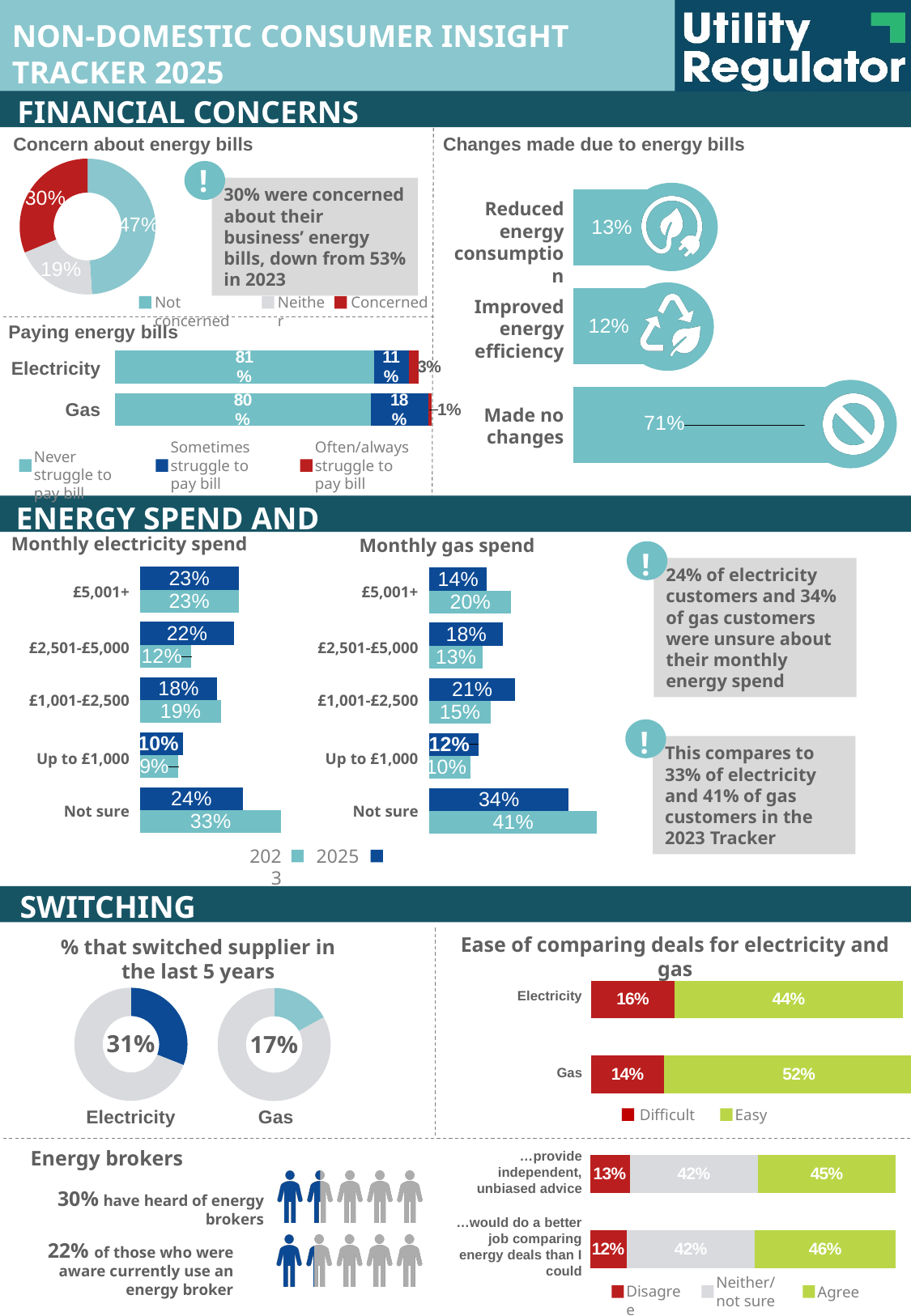
How many series does the legend of the 'Monthly gas spend' chart list? 2 In the 'Paying energy bills' chart, what percentage of gas customers sometimes struggle to pay their bill? 18% What kind of chart is the 'Ease of comparing deals for electricity and gas' chart? Bar chart In the 'Ease of comparing deals for electricity and gas' chart, what is the difference between the Easy values for gas and electricity? 8% In the 'Monthly electricity spend' chart, what is the difference between the 2023 and 2025 values for £2,501-£5,000? 10% In the 'Concern about energy bills' donut chart, which category has the largest share? Not concerned In the 'Monthly gas spend' chart, which is larger for £5,001+: the 2023 value or the 2025 value? 2023 In the 'Changes made due to energy bills' chart, what percentage made no changes? 71% In the 'Concern about energy bills' donut chart, what percentage were concerned? 30% In the 'Monthly electricity spend' chart, what is the 2025 value for 'Not sure'? 24% In the 'Changes made due to energy bills' chart, which change has the lowest percentage? Improved energy efficiency In the '% that switched supplier in the last 5 years' charts, what percentage switched gas supplier? 17%